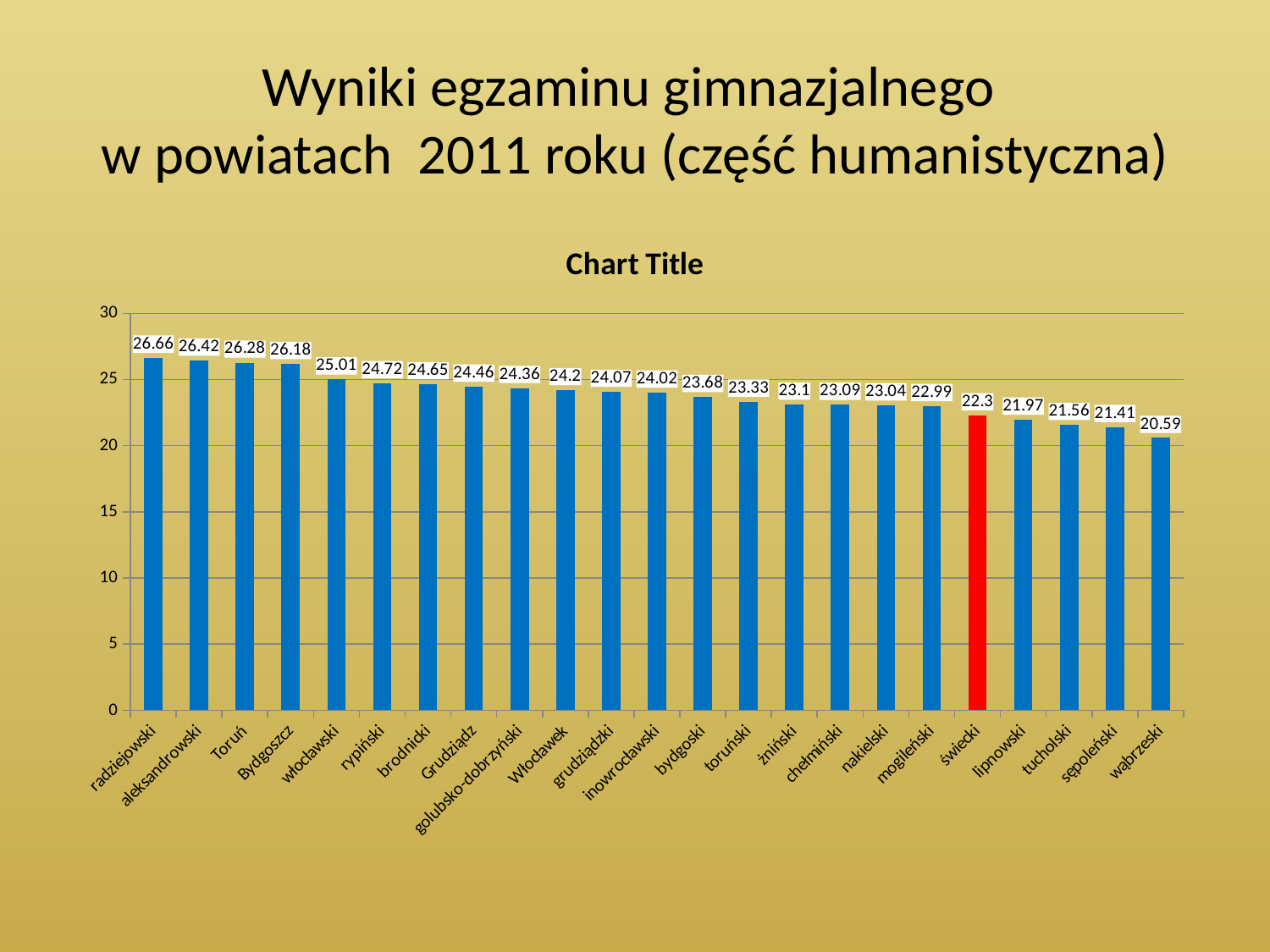
Which is larger, the value for włocławski or the value for Włocławek? włocławski What is the difference between the values for Toruń and Bydgoszcz? 0.1 Which category's bar is coloured red instead of blue? świecki Which category has the highest value? radziejowski What is the value for radziejowski? 26.66 Is the value for lipnowski greater or less than 25? less What kind of chart is shown on the slide? bar chart How many categories are shown on the x axis? 23 What is the value for świecki? 22.3 Which category has the lowest value? wąbrzeski What is the difference between the values for radziejowski and wąbrzeski? 6.07 What is the value for Bydgoszcz? 26.18